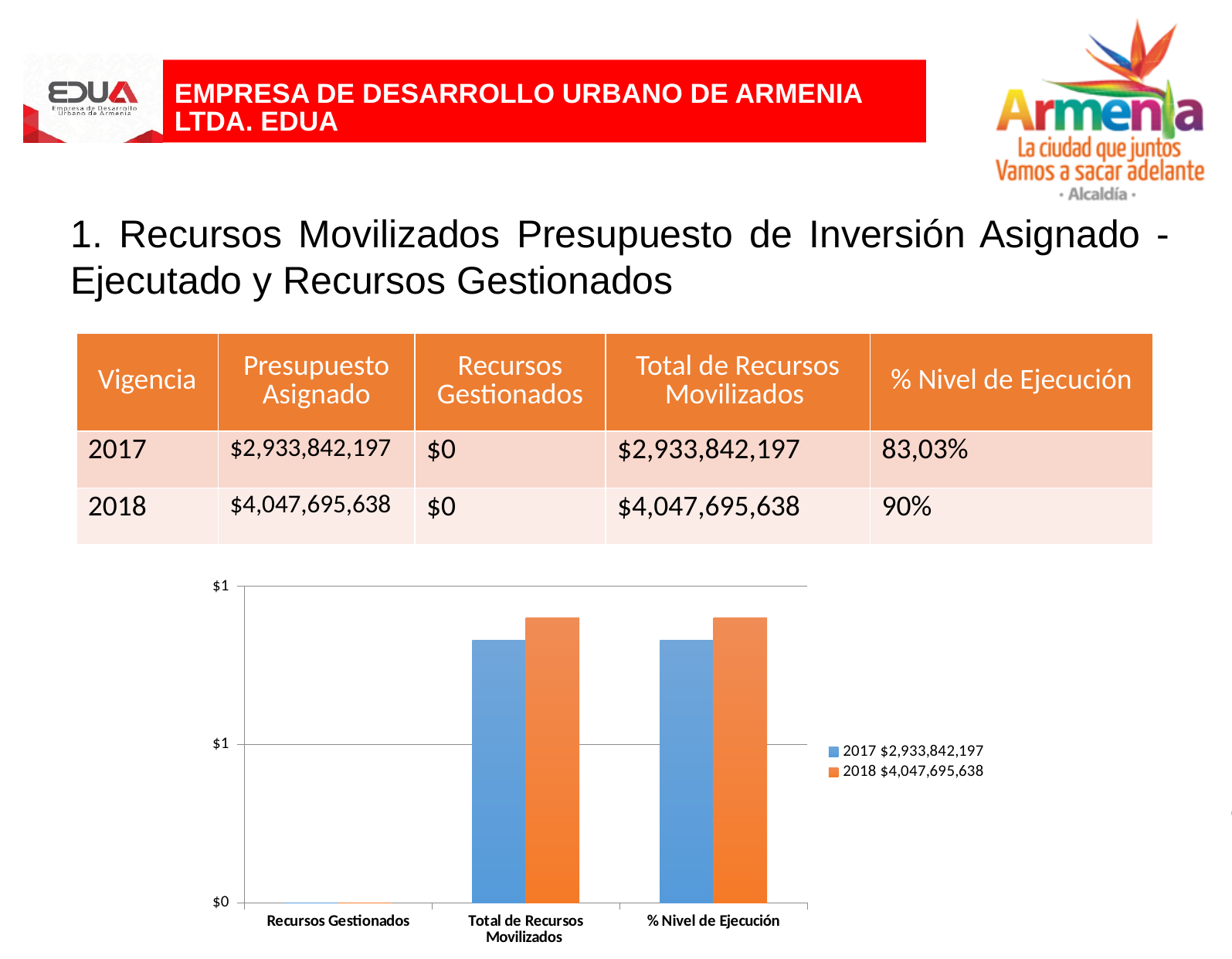
What colour are the bars for the 2018 series in the chart? orange How many series does the chart's legend list? 2 For % Nivel de Ejecución, which series has the taller bar, 2017 or 2018? 2018 Which series is shown in blue in the chart? 2017 $2,933,842,197 What is the label of the middle category on the x axis of the chart? Total de Recursos Movilizados For Total de Recursos Movilizados, which series has the taller bar, 2017 or 2018? 2018 What kind of chart is shown on the slide? bar chart Which category has the lowest bars in the chart? Recursos Gestionados What is the first entry in the chart's legend? 2017 $2,933,842,197 How many categories are shown along the x axis of the chart? 3